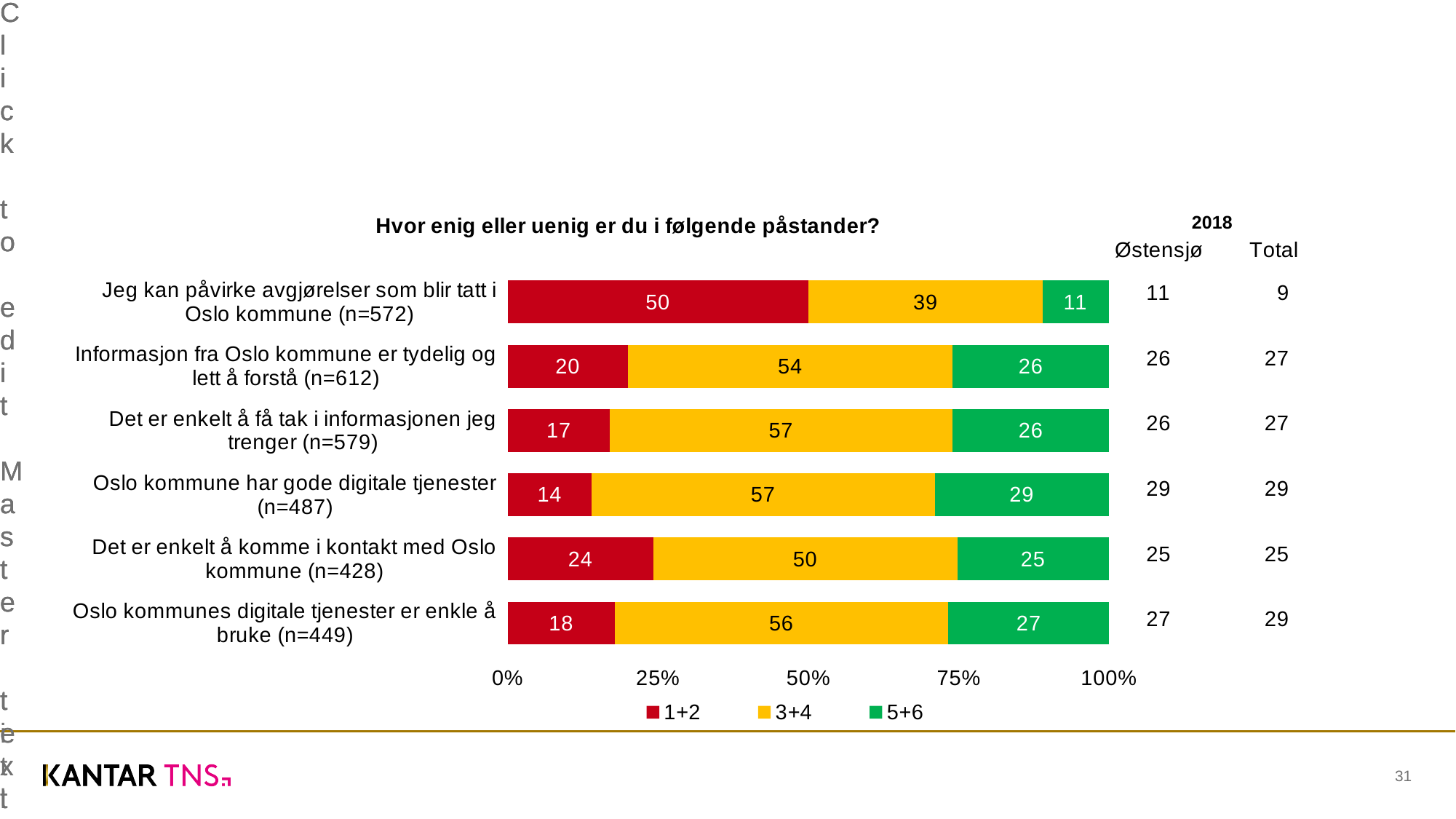
What kind of chart is shown on the slide? Stacked bar chart Which statement has the highest value for the 1+2 series? Jeg kan påvirke avgjørelser som blir tatt i Oslo kommune (n=572) How many statements (categories) are shown in the chart? 6 Which statement has the lowest value for the 5+6 series? Jeg kan påvirke avgjørelser som blir tatt i Oslo kommune (n=572) What is the value of the 1+2 series for "Jeg kan påvirke avgjørelser som blir tatt i Oslo kommune (n=572)"? 50 What is the title of the chart? Hvor enig eller uenig er du i følgende påstander? Which statement has the highest value for the 5+6 series? Oslo kommune har gode digitale tjenester (n=487) What is the difference between the 1+2 values for "Det er enkelt å komme i kontakt med Oslo kommune (n=428)" and "Oslo kommune har gode digitale tjenester (n=487)"? 10 How many series does the legend list? 3 What is the value of the 5+6 series for "Oslo kommunes digitale tjenester er enkle å bruke (n=449)"? 27 Is the 3+4 value larger for "Informasjon fra Oslo kommune er tydelig og lett å forstå (n=612)" or for "Jeg kan påvirke avgjørelser som blir tatt i Oslo kommune (n=572)"? Informasjon fra Oslo kommune er tydelig og lett å forstå (n=612) What is the value of the 3+4 series for "Det er enkelt å få tak i informasjonen jeg trenger (n=579)"? 57